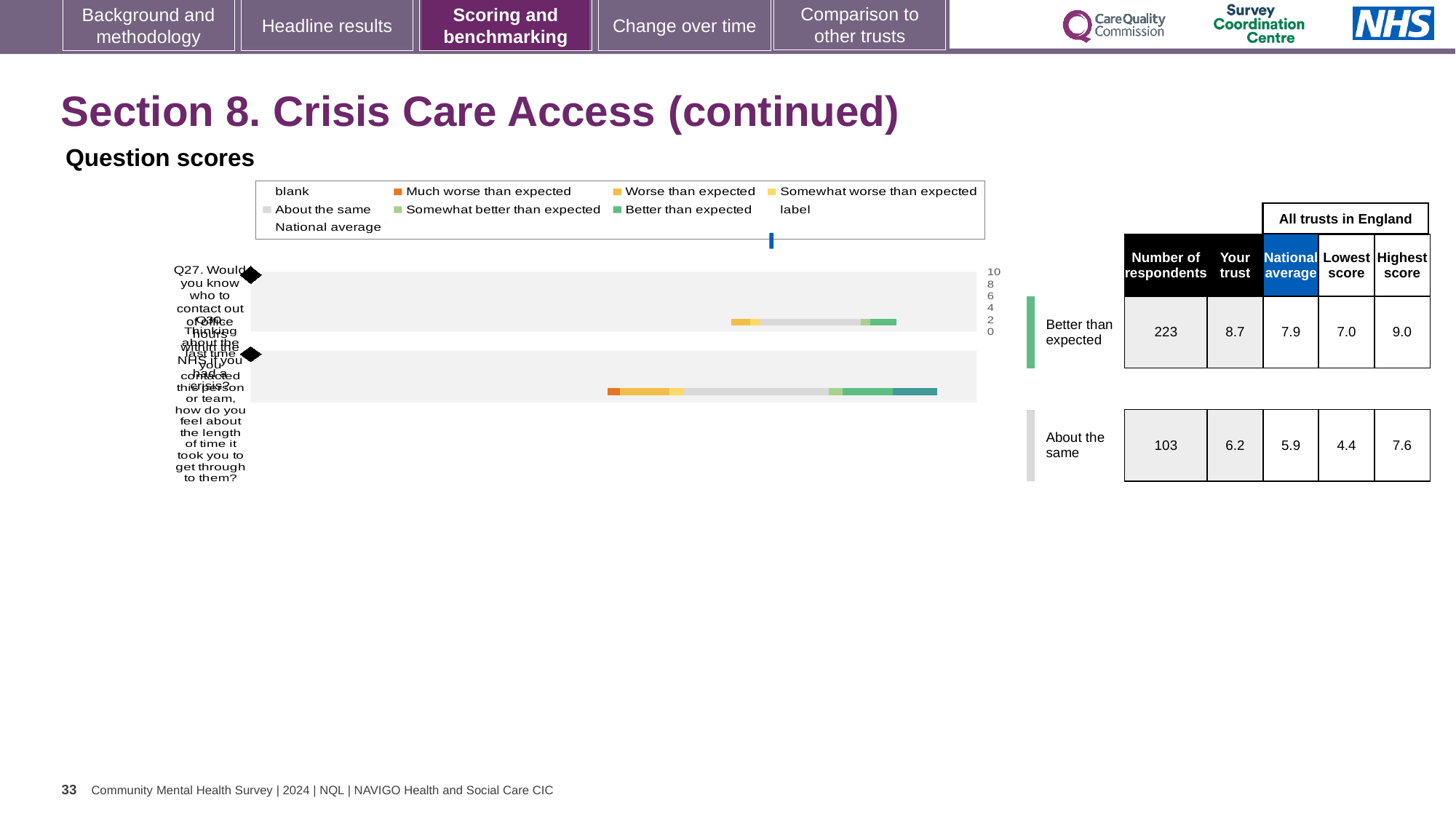
How many respondents answered Q27? 223 What is the maximum value shown on the chart's score axis? 10 How many questions (bars) are plotted in the question scores chart? 2 What is the highest score across all trusts in England for Q30? 7.6 What kind of chart is used to show the question scores on this slide? bar chart Which question has the higher 'Your trust' score, Q27 or Q30? Q27 What is the difference between the trust's score and the national average for Q27? 0.8 What benchmark category is shown for Q27? Better than expected What is the national average score for Q30 (how do you feel about the length of time it took to get through)? 5.9 Is the trust's score for Q30 greater or less than 8? less What is the 'Your trust' score for Q27 (would you know who to contact out of office hours)? 8.7 What is the lowest score across all trusts in England for Q27? 7.0